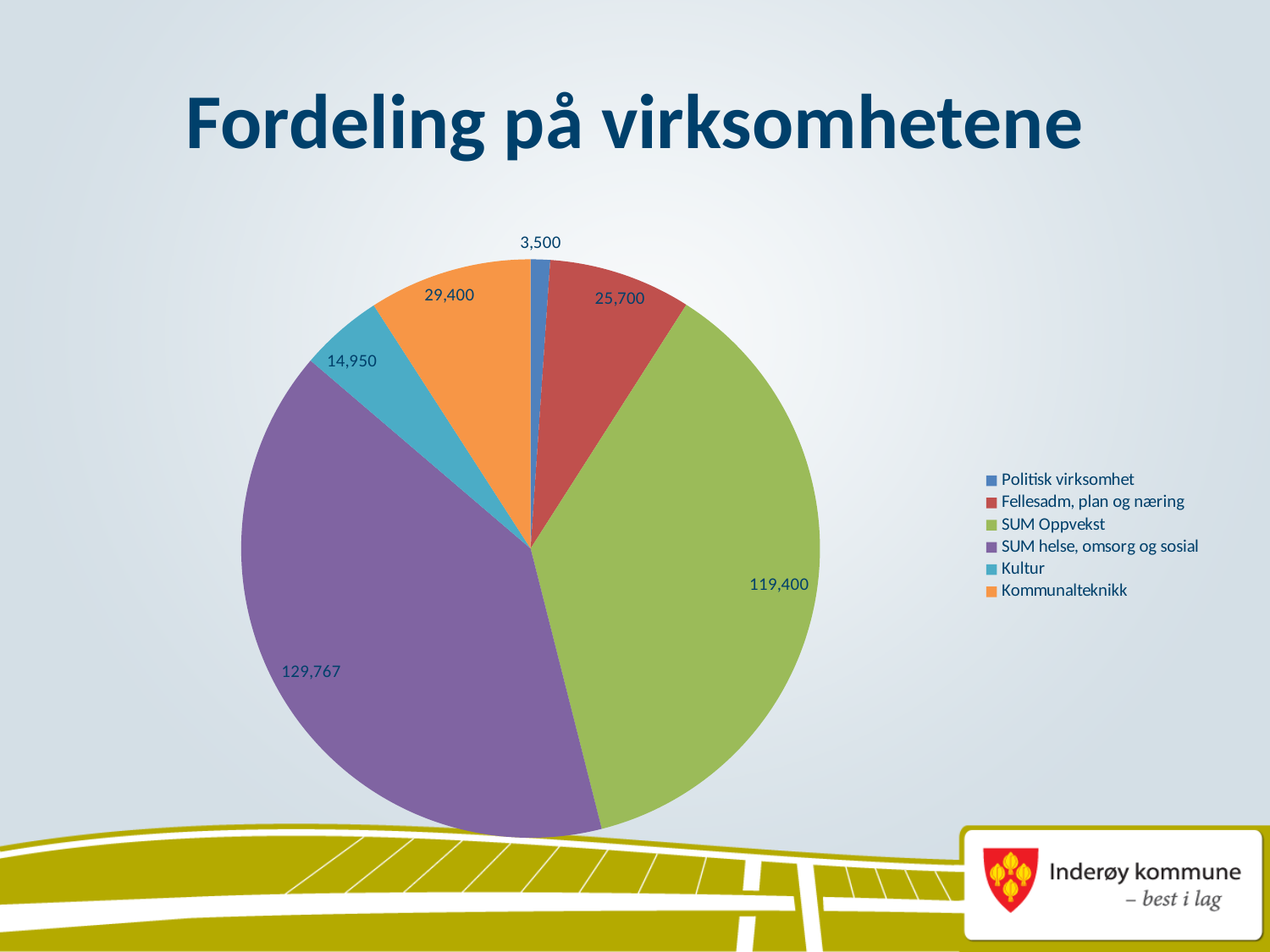
What is the title of the chart? Fordeling på virksomhetene What is the value for Kultur? 14,950 What is the difference between the values for SUM helse, omsorg og sosial and SUM Oppvekst? 10,367 What is the value for Kommunalteknikk? 29,400 Which is larger, the value for Kommunalteknikk or the value for Fellesadm, plan og næring? Kommunalteknikk What is the value for SUM Oppvekst? 119,400 What is the value for Politisk virksomhet? 3,500 What colour is the slice for Kultur? Teal (light blue) Which category has the largest slice? SUM helse, omsorg og sosial What type of chart is shown on the slide? Pie chart How many categories does the legend list? 6 Which category has the smallest slice? Politisk virksomhet